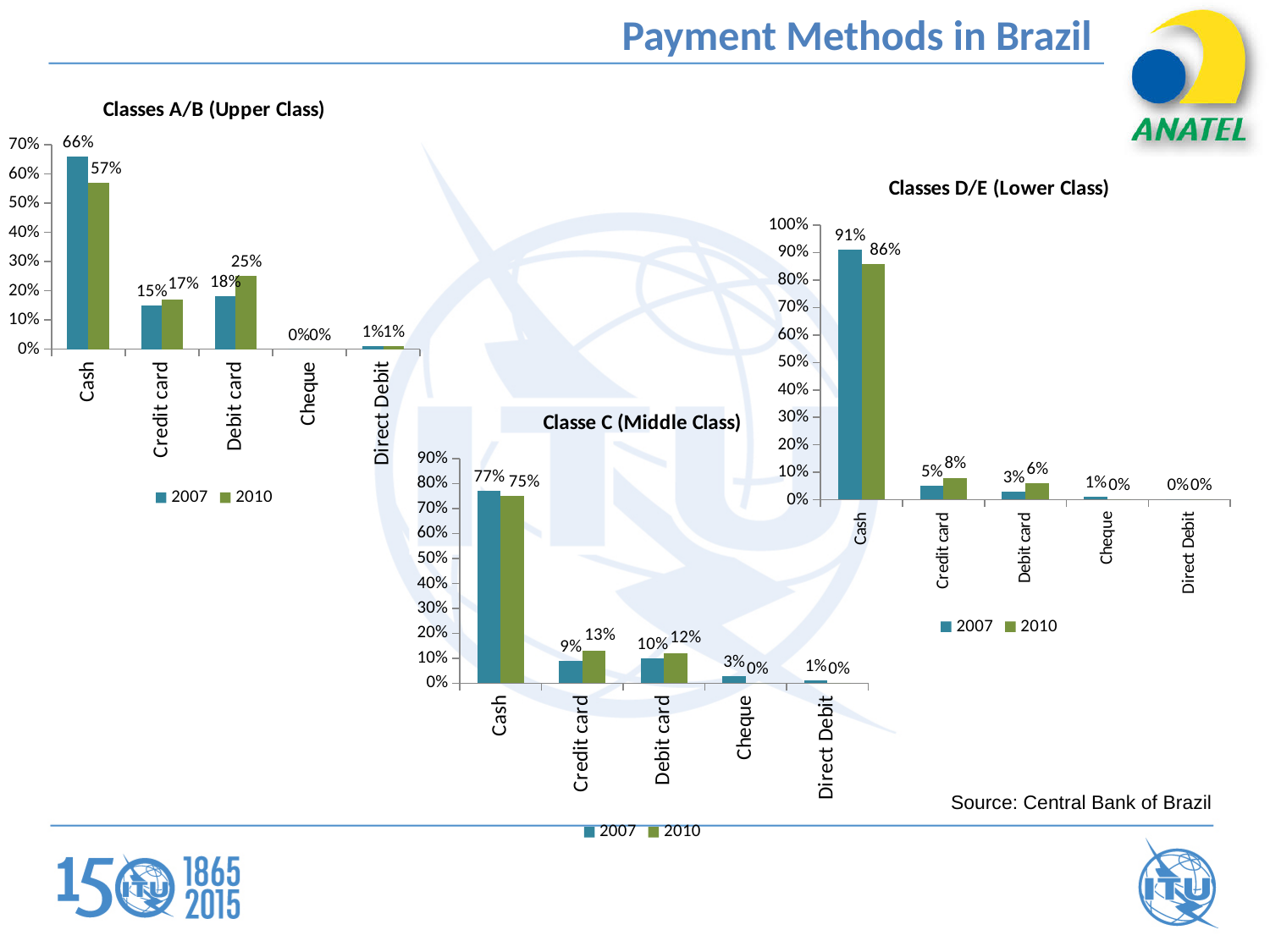
In the 'Classes D/E (Lower Class)' chart, what is the difference between the 2010 and 2007 values for Credit card? 3% In the 'Classes D/E (Lower Class)' chart, what is the value for Cash in 2010? 86% In the 'Classe C (Middle Class)' chart, what is the value for Credit card in 2010? 13% How many charts are shown on the slide? 3 In the 'Classe C (Middle Class)' chart, is the 2007 value for Cheque larger or the 2010 value for Cheque? 2007 In the 'Classes A/B (Upper Class)' chart, what is the difference between the 2007 and 2010 values for Cash? 9% In the 'Classes A/B (Upper Class)' chart, what is the value for Cash in 2007? 66% In the 'Classe C (Middle Class)' chart, which category has the highest value in 2007? Cash What kind of chart is the 'Classe C (Middle Class)' chart? Bar chart In the 'Classes D/E (Lower Class)' chart, how many series does the legend list? 2 In the 'Classes A/B (Upper Class)' chart, what is the value for Debit card in 2010? 25% How many categories are shown on the x axis of the 'Classes A/B (Upper Class)' chart? 5